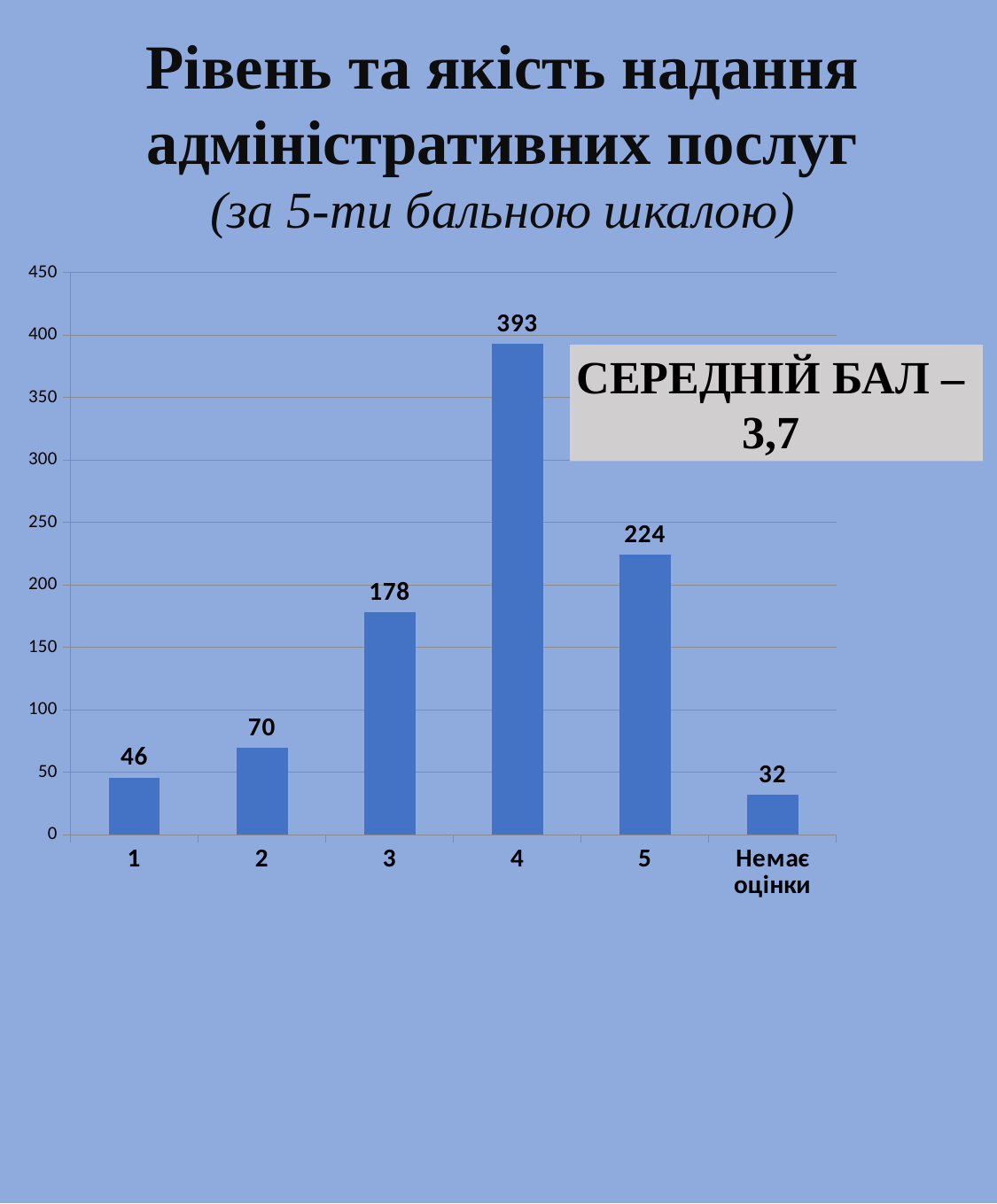
Which is larger, the value for category 5 or the value for category 3? 5 Which category has the lowest value? Немає оцінки How many categories are shown on the x axis? 6 What average score (середній бал) is stated in the box on the chart? 3,7 Which category has the highest value? 4 What is the value for the 'Немає оцінки' category? 32 What is the value for category 4? 393 What kind of chart is shown on the slide? bar chart What is the difference between the values for category 4 and category 5? 169 Is the value for category 5 greater or less than 200? greater What is the value for category 2? 70 What is the difference between the values for category 3 and category 1? 132